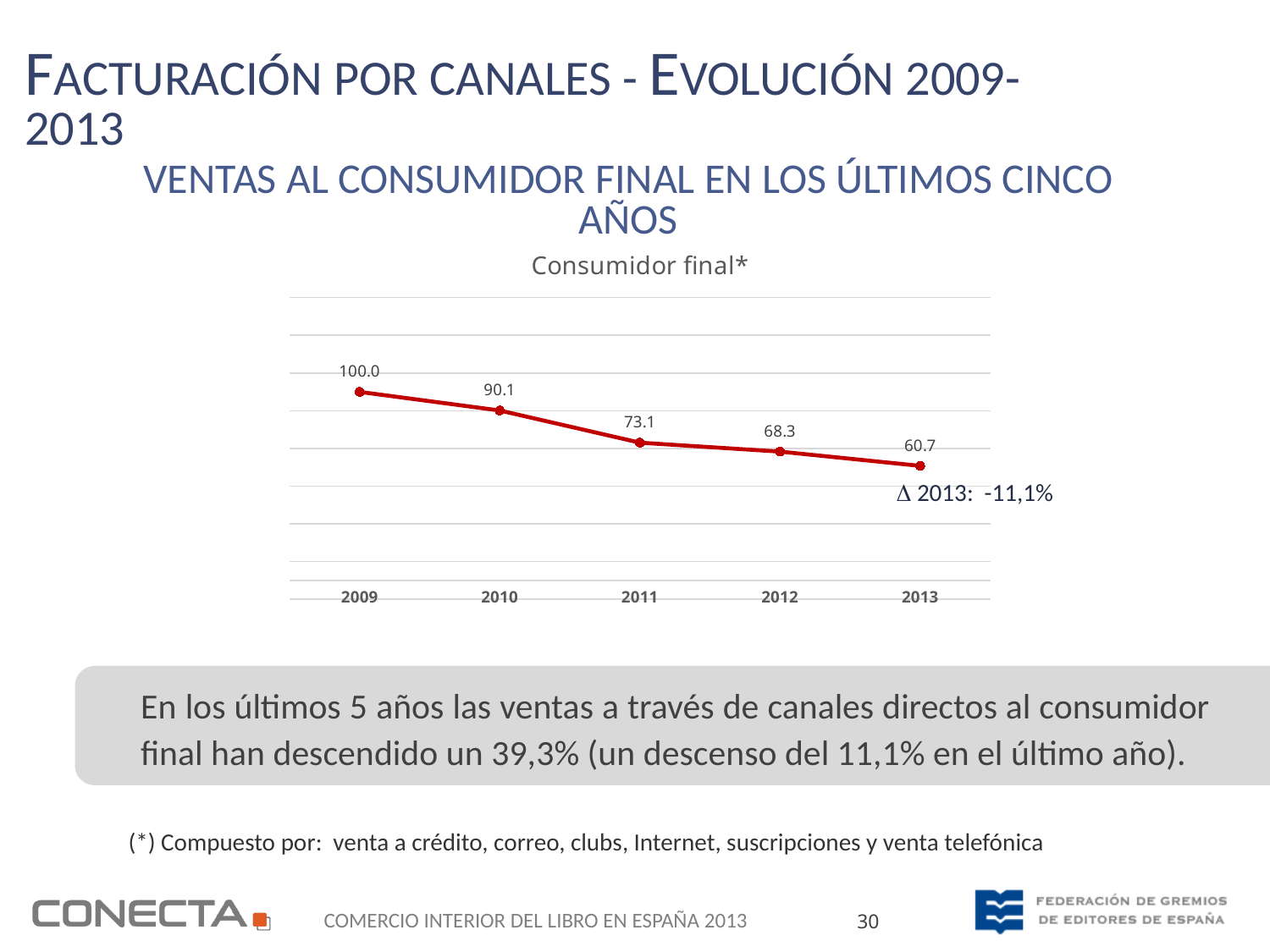
What is the difference between the values for 2009 and 2013 in the Consumidor final* chart? 39.3 What is the difference between the values for 2011 and 2012 in the Consumidor final* chart? 4.8 Which year has the lowest value in the Consumidor final* chart? 2013 How many years are plotted in the Consumidor final* chart? 5 What is the value for 2009 in the Consumidor final* chart? 100.0 Which year has the highest value in the Consumidor final* chart? 2009 Which is larger in the Consumidor final* chart, the value for 2010 or the value for 2012? 2010 What kind of chart is the Consumidor final* chart? line chart What is the value for 2013 in the Consumidor final* chart? 60.7 What is the value for 2011 in the Consumidor final* chart? 73.1 Do the values in the Consumidor final* chart rise or fall from 2009 to 2013? fall What is the value for 2010 in the Consumidor final* chart? 90.1